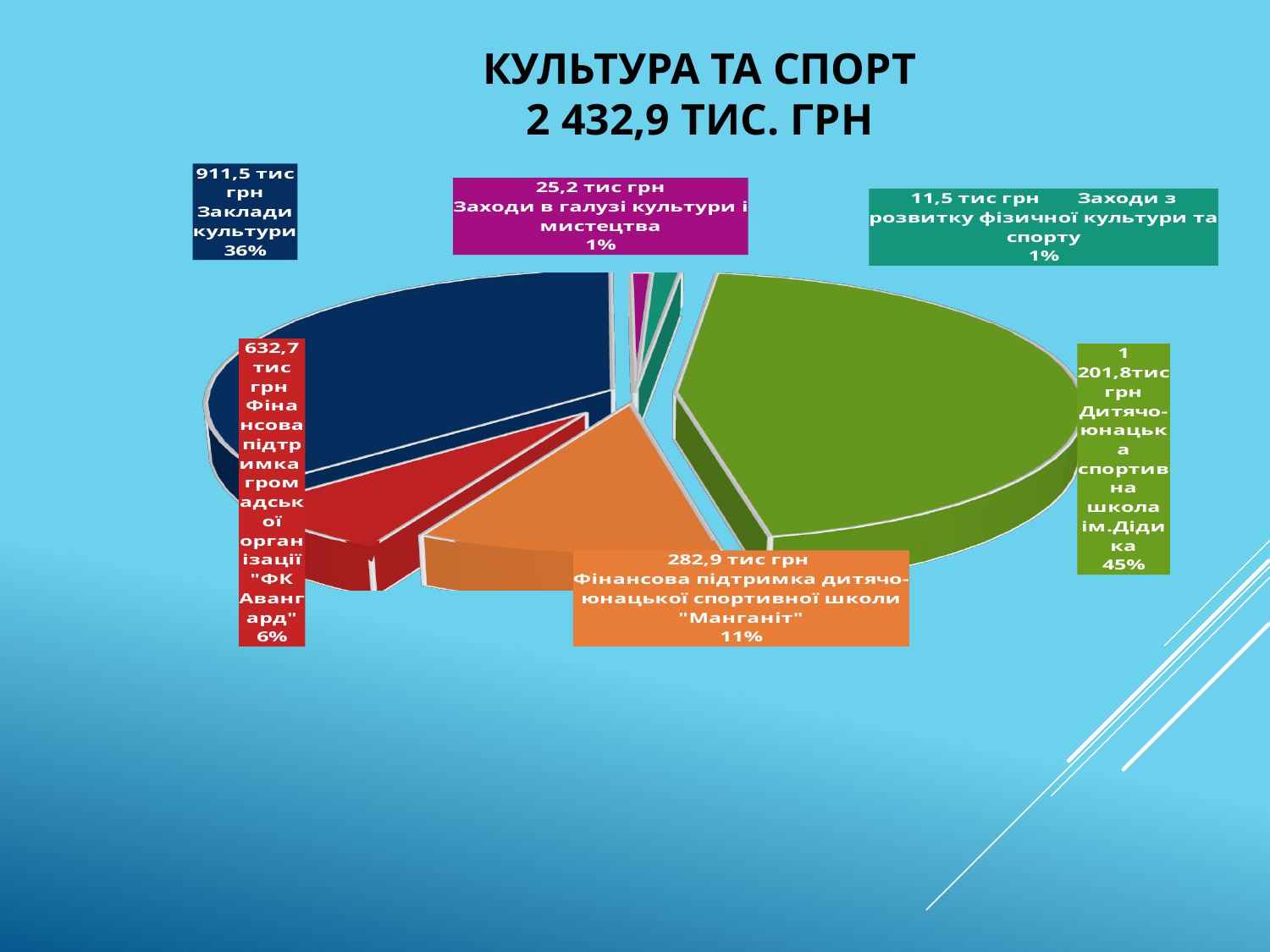
What is the value for Заклади культури? 911,5 тис грн What is the value for Дитячо-юнацька спортивна школа ім.Дідика? 1 201,8 тис грн What kind of chart is shown on the slide? pie chart What share of the pie does Заклади культури represent? 36% How many slices does the pie chart have? 6 What is the difference between the values for Дитячо-юнацька спортивна школа ім.Дідика and Заклади культури? 290,3 тис грн What is the value for Заходи в галузі культури і мистецтва? 25,2 тис грн What share of the pie does Фінансова підтримка дитячо-юнацької спортивної школи "Манганіт" represent? 11% What is the value for Фінансова підтримка дитячо-юнацької спортивної школи "Манганіт"? 282,9 тис грн Which category has the smallest value? Заходи з розвитку фізичної культури та спорту Which category has the largest slice of the pie? Дитячо-юнацька спортивна школа ім.Дідика